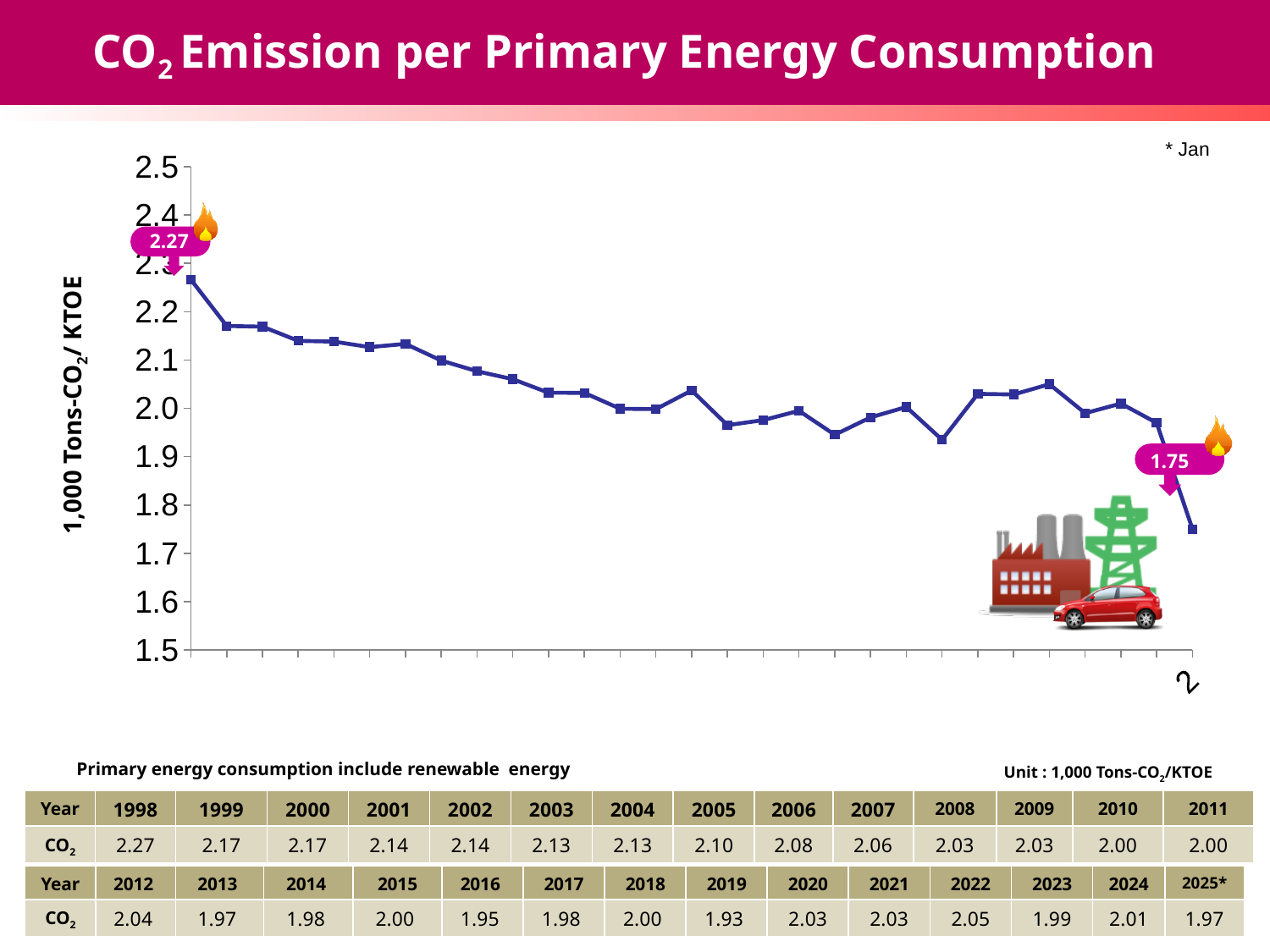
According to the table, which year has the highest CO2 value? 1998 What is the difference between the first callout value (2.27) and the last callout value (1.75)? 0.52 What is the title of the chart on the slide? CO2 Emission per Primary Energy Consumption Which is larger, the CO2 value for 2005 or for 2022? 2005 What value is shown in the callout at the start of the line? 2.27 Is the last plotted point on the line greater or less than 1.8? less Overall, do the values rise or fall from left to right along the x axis? fall What is the y-axis label of the chart? 1,000 Tons-CO2/ KTOE What value is shown in the callout at the end of the line? 1.75 What kind of chart is shown on the slide? line chart According to the table, what is the CO2 value for 2019? 1.93 According to the table, what is the CO2 value for 2012? 2.04